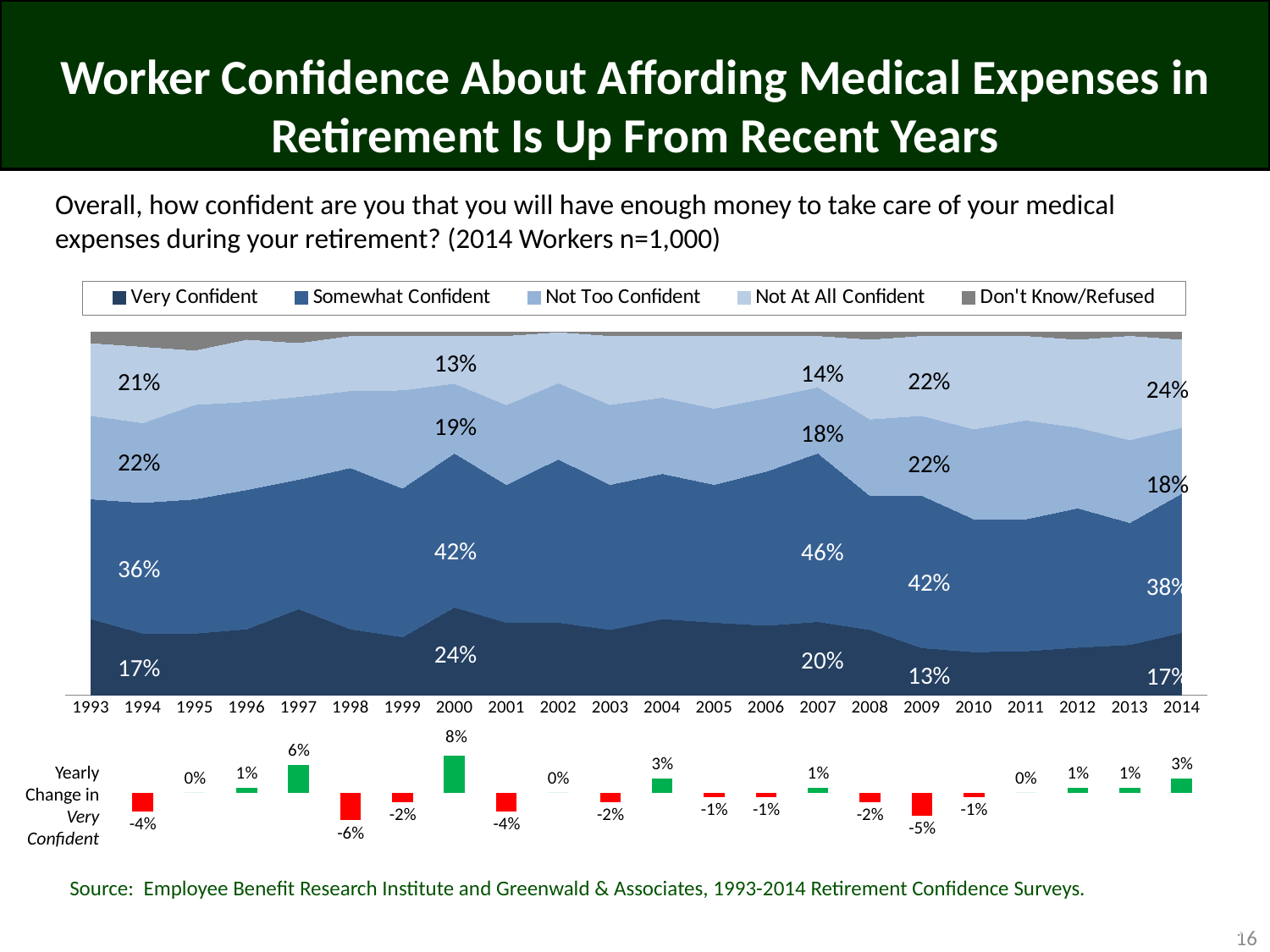
How many years are shown on the x axis of the main chart? 22 In the main chart, what percentage of workers were Very Confident in 2000? 24% In the main chart, what is the difference in the Very Confident share between 2000 and 2009? 11 percentage points In the main chart, what percentage of workers were Somewhat Confident in 2007? 46% In the Yearly Change in Very Confident bar chart, what is the value for 2009? -5% In the main chart, was the Somewhat Confident share larger in 2007 or in 2014? 2007 In the Yearly Change in Very Confident bar chart, which year has the largest increase? 2000 In the main chart, what percentage of workers were Not At All Confident in 2014? 24% In the Yearly Change in Very Confident bar chart, which year has the largest decrease? 1998 How many series does the legend of the main chart list? 5 What kind of chart is the main chart showing confidence levels from 1993 to 2014? Stacked area chart